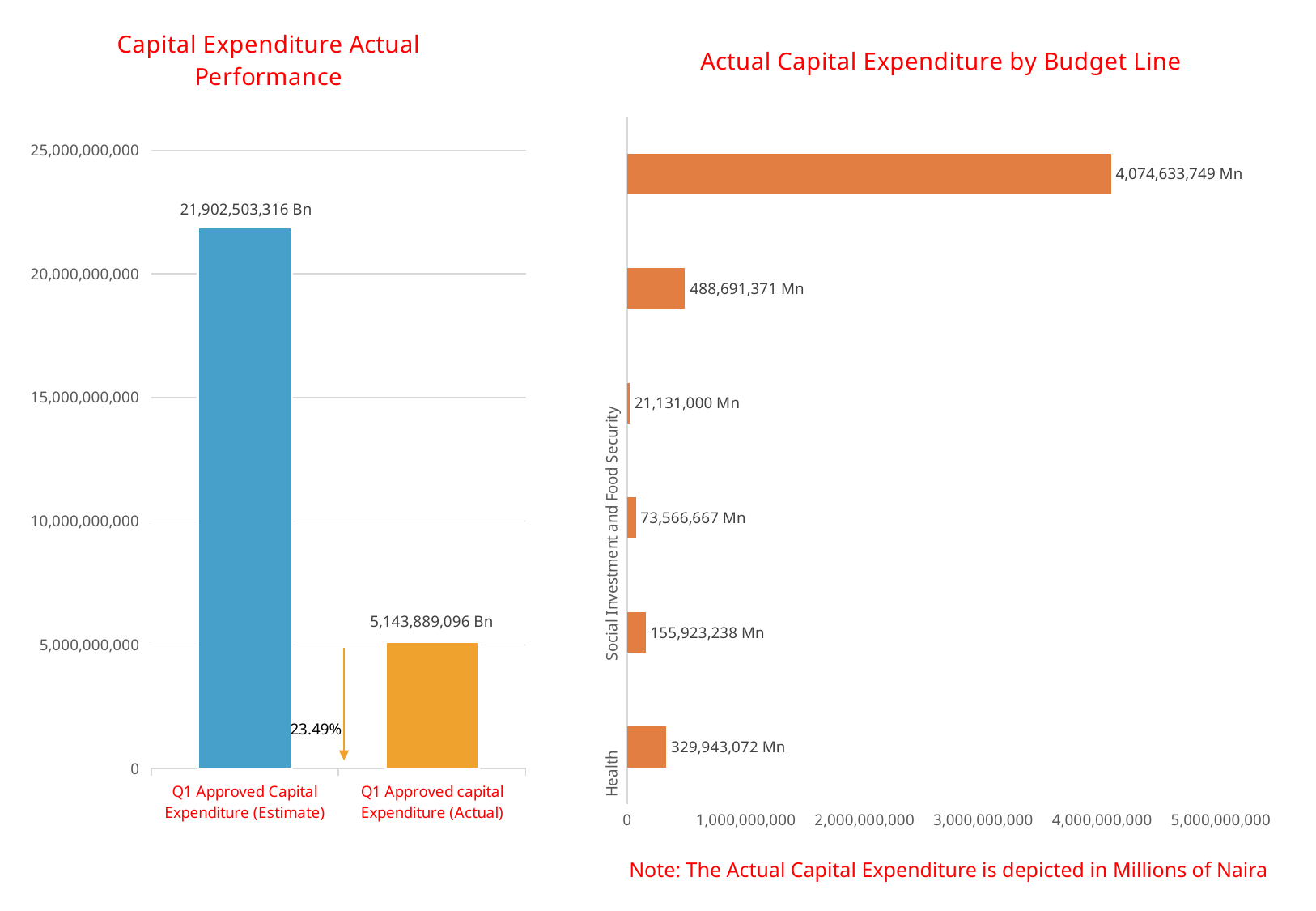
In the 'Actual Capital Expenditure by Budget Line' chart, is the value for Health greater or less than 1,000,000,000? less In the 'Capital Expenditure Actual Performance' chart, which of the two bars is larger? Q1 Approved Capital Expenditure (Estimate) In the 'Actual Capital Expenditure by Budget Line' chart, what is the value of the smallest bar? 21,131,000 Mn In the 'Capital Expenditure Actual Performance' chart, what is the difference between the Estimate and the Actual values? 16,758,614,220 Bn In the 'Actual Capital Expenditure by Budget Line' chart, what is the value of the largest bar? 4,074,633,749 Mn How many bars are plotted in the 'Capital Expenditure Actual Performance' chart? 2 What kind of chart is 'Capital Expenditure Actual Performance'? Bar chart In the 'Capital Expenditure Actual Performance' chart, what is the value for Q1 Approved capital Expenditure (Actual)? 5,143,889,096 Bn In the 'Capital Expenditure Actual Performance' chart, what percentage is shown next to the arrow between the two bars? 23.49% In the 'Capital Expenditure Actual Performance' chart, what is the value for Q1 Approved Capital Expenditure (Estimate)? 21,902,503,316 Bn How many bars are plotted in the 'Actual Capital Expenditure by Budget Line' chart? 6 In the 'Actual Capital Expenditure by Budget Line' chart, what is the value for Health? 329,943,072 Mn